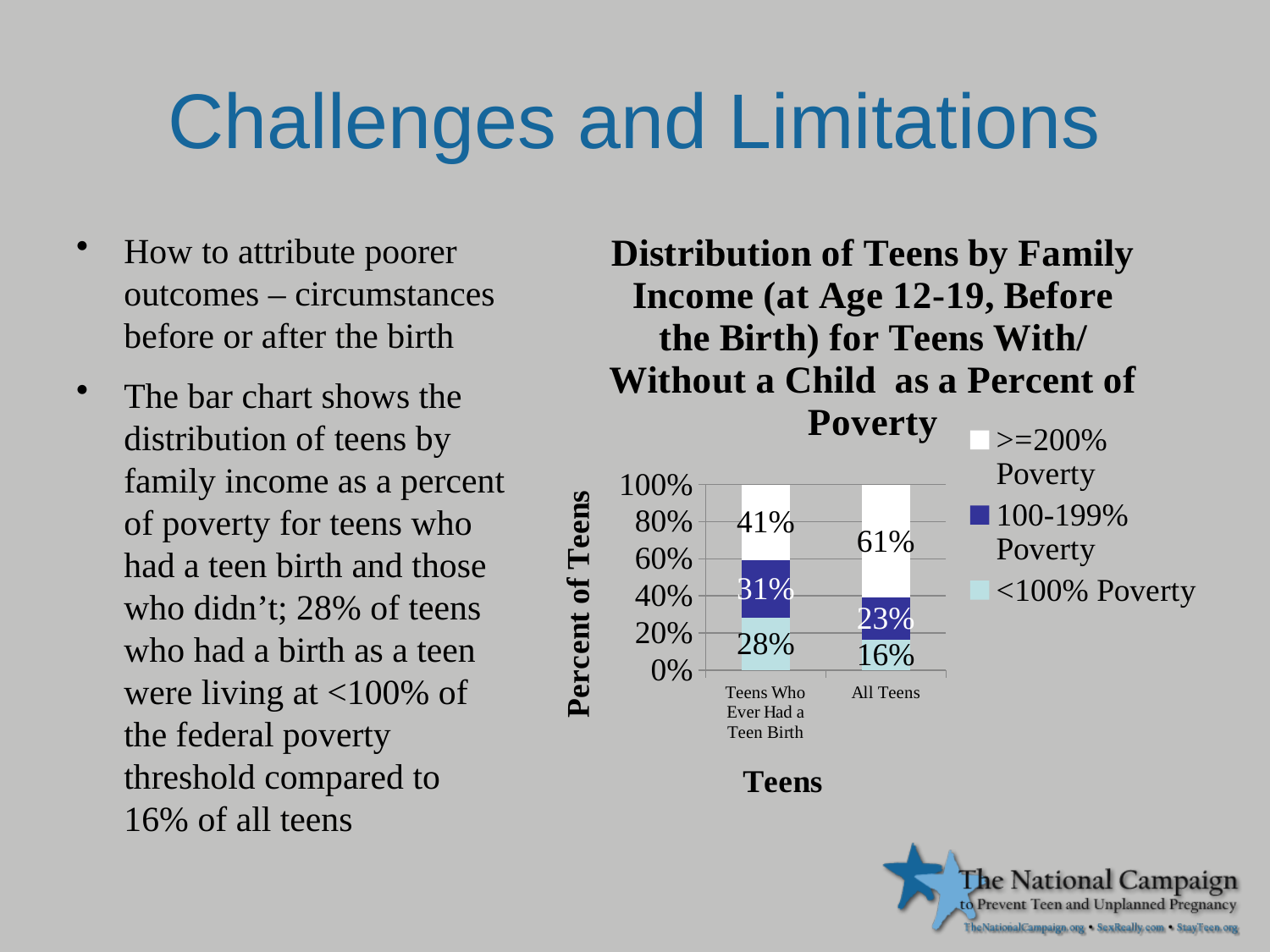
What kind of chart is shown on the slide? stacked bar chart What percentage of all teens were at 100-199% poverty? 23% What is the difference between the >=200% poverty share for all teens and for teens who ever had a teen birth? 20% What percentage of teens who ever had a teen birth were living at <100% poverty? 28% How many series does the chart legend list? 3 What percentage of all teens were at >=200% poverty? 61% What is the difference between the <100% poverty share for teens who ever had a teen birth and for all teens? 12% What percentage of all teens were living at <100% poverty? 16% How many categories are shown on the x axis of the chart? 2 What is the label on the y axis of the chart? Percent of Teens What percentage of teens who ever had a teen birth were at 100-199% poverty? 31% Which group has the larger share at >=200% poverty, teens who ever had a teen birth or all teens? All Teens